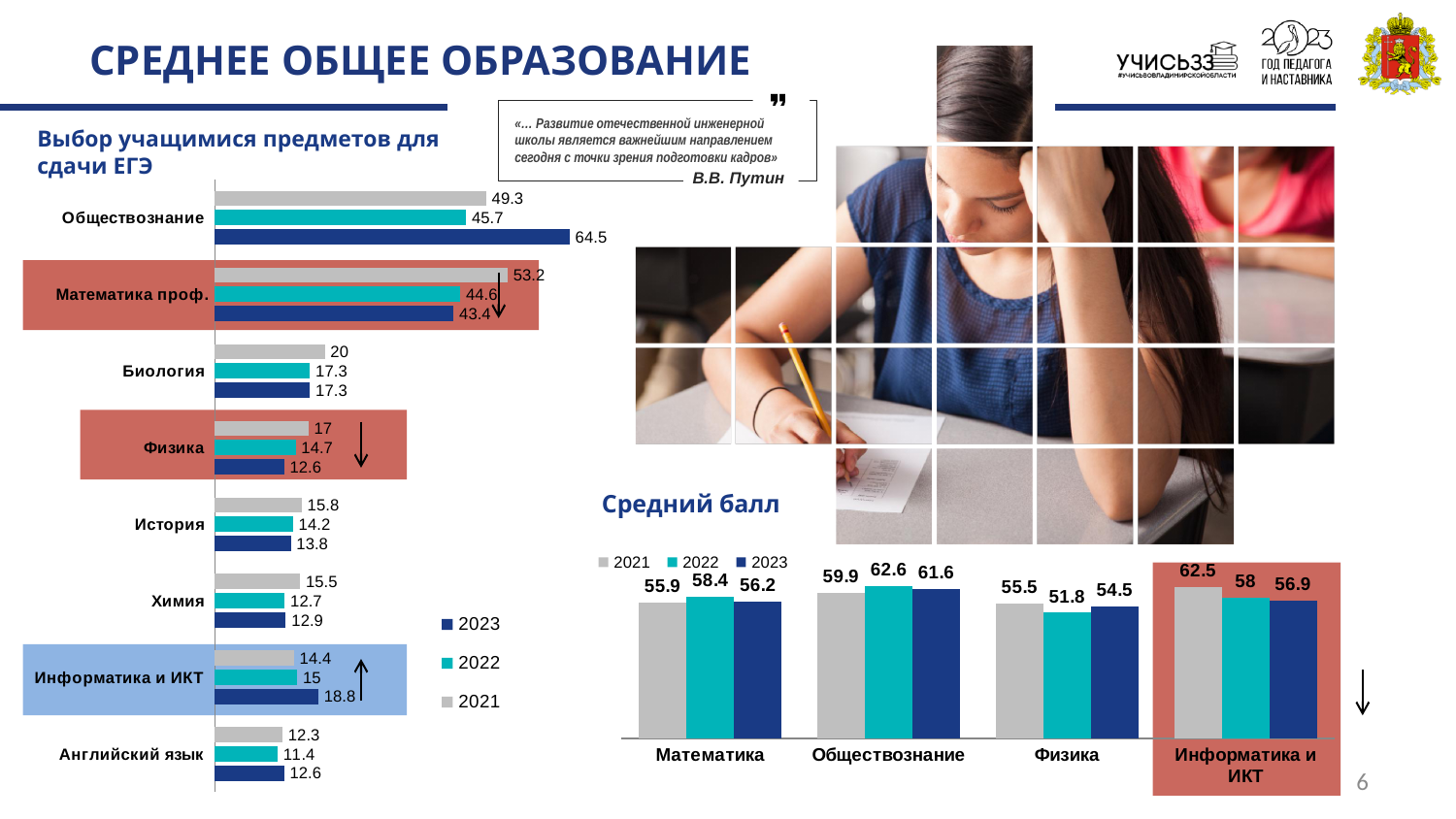
In the chart "Выбор учащимися предметов для сдачи ЕГЭ", what is the value for Информатика и ИКТ in 2021? 14.4 In the chart "Выбор учащимися предметов для сдачи ЕГЭ", which subject has the highest value for 2023? Обществознание In the chart "Выбор учащимися предметов для сдачи ЕГЭ", what kind of chart is it? Bar chart In the chart "Выбор учащимися предметов для сдачи ЕГЭ", which subject has the lowest value for 2022? Английский язык In the chart "Средний балл", which subject has the highest value for 2021? Информатика и ИКТ In the chart "Средний балл", what is the value for Физика in 2022? 51.8 In the chart "Средний балл", do the values for Информатика и ИКТ rise or fall from 2021 to 2023? Fall In the chart "Средний балл", is the 2022 value for Математика larger or smaller than the 2022 value for Обществознание? Smaller In the chart "Средний балл", how many series does the legend list? 3 In the chart "Выбор учащимися предметов для сдачи ЕГЭ", what is the difference between the 2023 and 2021 values for Физика? 4.4 In the chart "Выбор учащимися предметов для сдачи ЕГЭ", what is the value for Обществознание in 2023? 64.5 In the chart "Выбор учащимися предметов для сдачи ЕГЭ", how many subjects are shown? 8